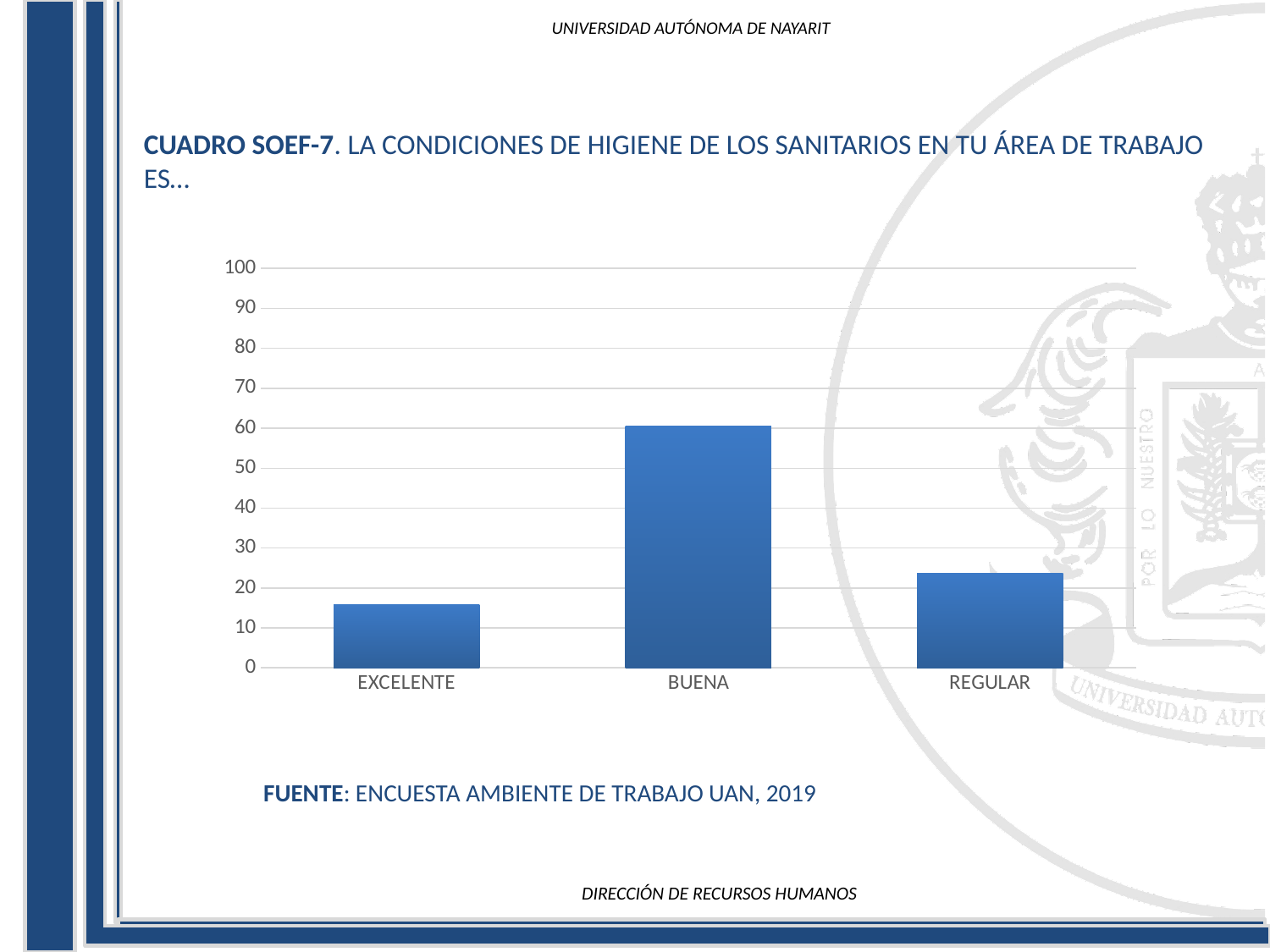
What source is cited below the chart? ENCUESTA AMBIENTE DE TRABAJO UAN, 2019 Is the value for EXCELENTE greater or less than 20? less Which category has the lowest bar in the chart? EXCELENTE Is the value for BUENA greater or less than 70? less What kind of chart is shown on the slide? bar chart Is the value for BUENA greater or less than 50? greater Which is larger, the value for REGULAR or the value for EXCELENTE? REGULAR What is the maximum value shown on the vertical axis of the chart? 100 Which category has the highest bar in the chart? BUENA How many categories are shown on the x axis of the chart? 3